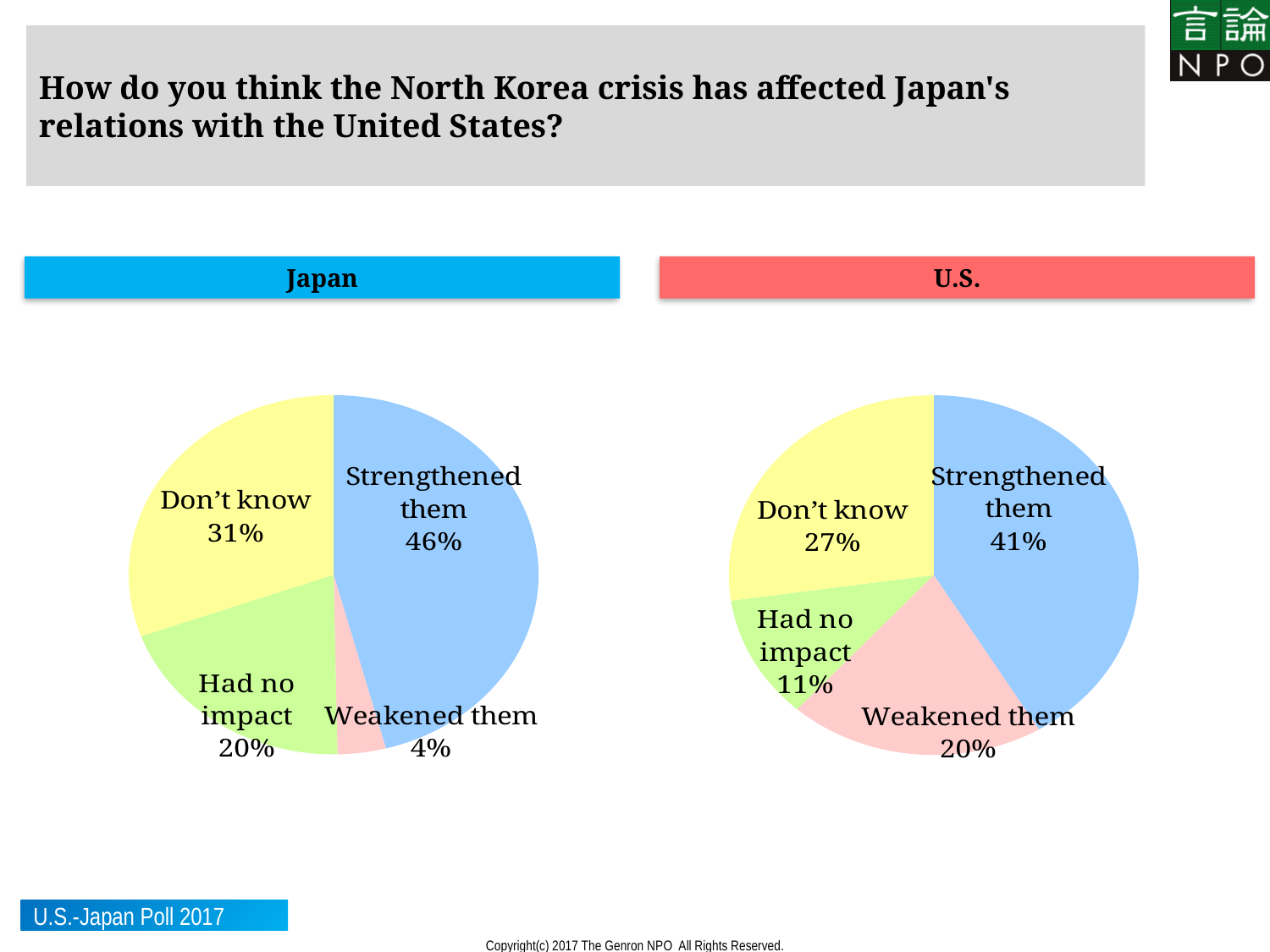
What type of chart is used to show the Japan results? Pie chart In the U.S. pie chart, what percentage said the crisis had no impact? 11% How many slices does the Japan pie chart have? 4 In the Japan pie chart, what percentage of respondents said the North Korea crisis strengthened Japan's relations with the United States? 46% In the U.S. pie chart, which response has the largest share? Strengthened them What colour is the 'Don't know' slice in both pie charts? Yellow Which is larger: the 'Had no impact' share in the Japan chart or in the U.S. chart? Japan In the U.S. pie chart, what percentage of respondents answered 'Don't know'? 27% What is the difference between the 'Weakened them' share in the U.S. chart and the 'Weakened them' share in the Japan chart? 16 percentage points In the Japan pie chart, which response has the smallest share? Weakened them In the U.S. pie chart, what is the difference between the 'Strengthened them' and 'Don't know' shares? 14 percentage points In the Japan pie chart, what is the combined share of 'Strengthened them' and 'Weakened them'? 50%